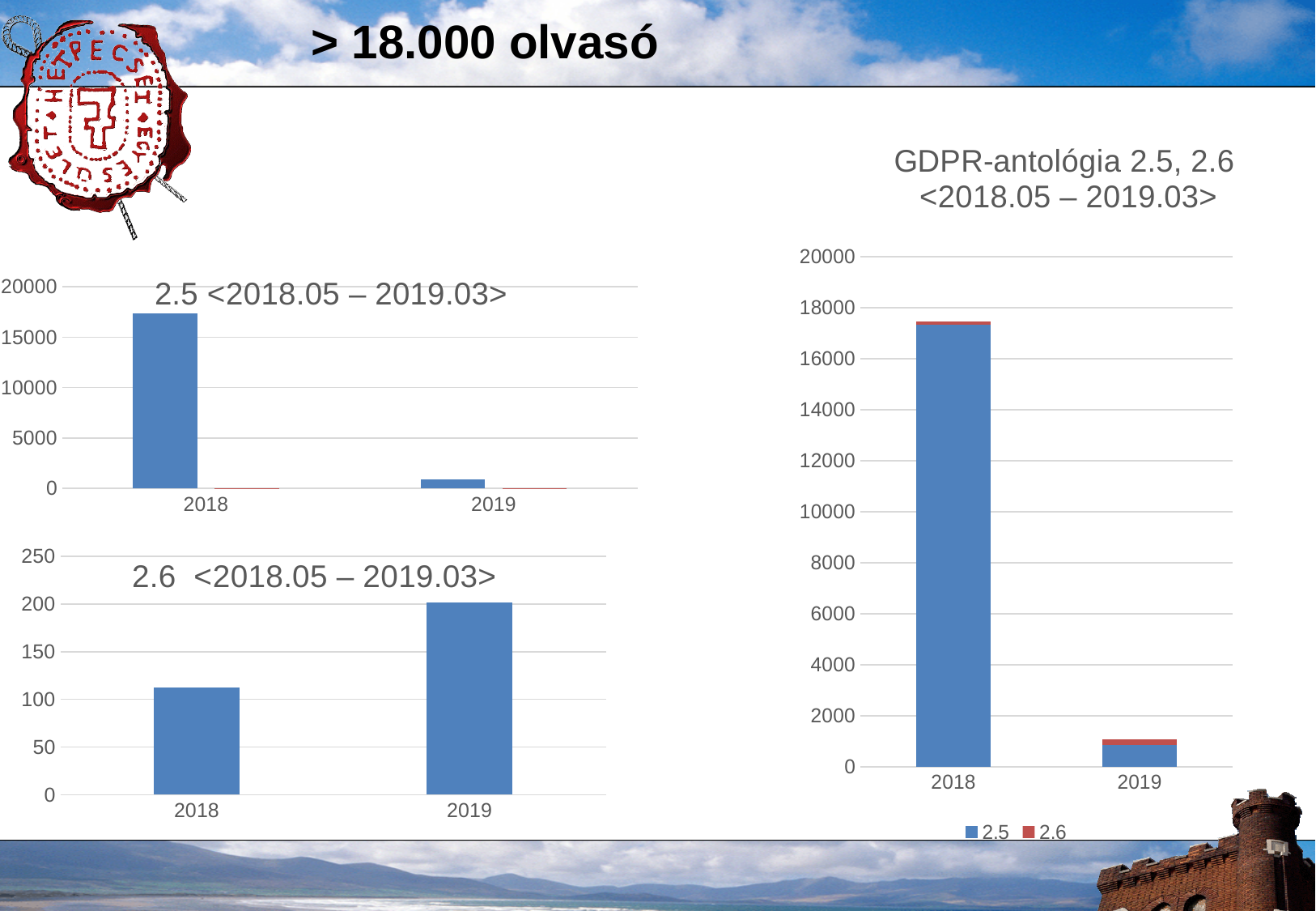
In the chart titled "GDPR-antológia 2.5, 2.6" (right), is the total stacked value for 2019 greater or less than 2000? less How many series does the legend of the chart titled "GDPR-antológia 2.5, 2.6" (right) list? 2 In the chart titled "2.6 <2018.05 – 2019.03>" (bottom left), is the value for 2018 greater or less than 150? less In the chart titled "2.6 <2018.05 – 2019.03>" (bottom left), do the values rise or fall from 2018 to 2019? rise In the chart titled "2.5 <2018.05 – 2019.03>" (top left), is the value for 2018 greater or less than 15000? greater In the chart titled "2.5 <2018.05 – 2019.03>" (top left), do the values rise or fall from 2018 to 2019? fall In the chart titled "2.6 <2018.05 – 2019.03>" (bottom left), which year has the lowest value? 2018 What kind of chart is the chart titled "GDPR-antológia 2.5, 2.6" (right)? stacked bar chart In the chart titled "2.5 <2018.05 – 2019.03>" (top left), which year has the highest value? 2018